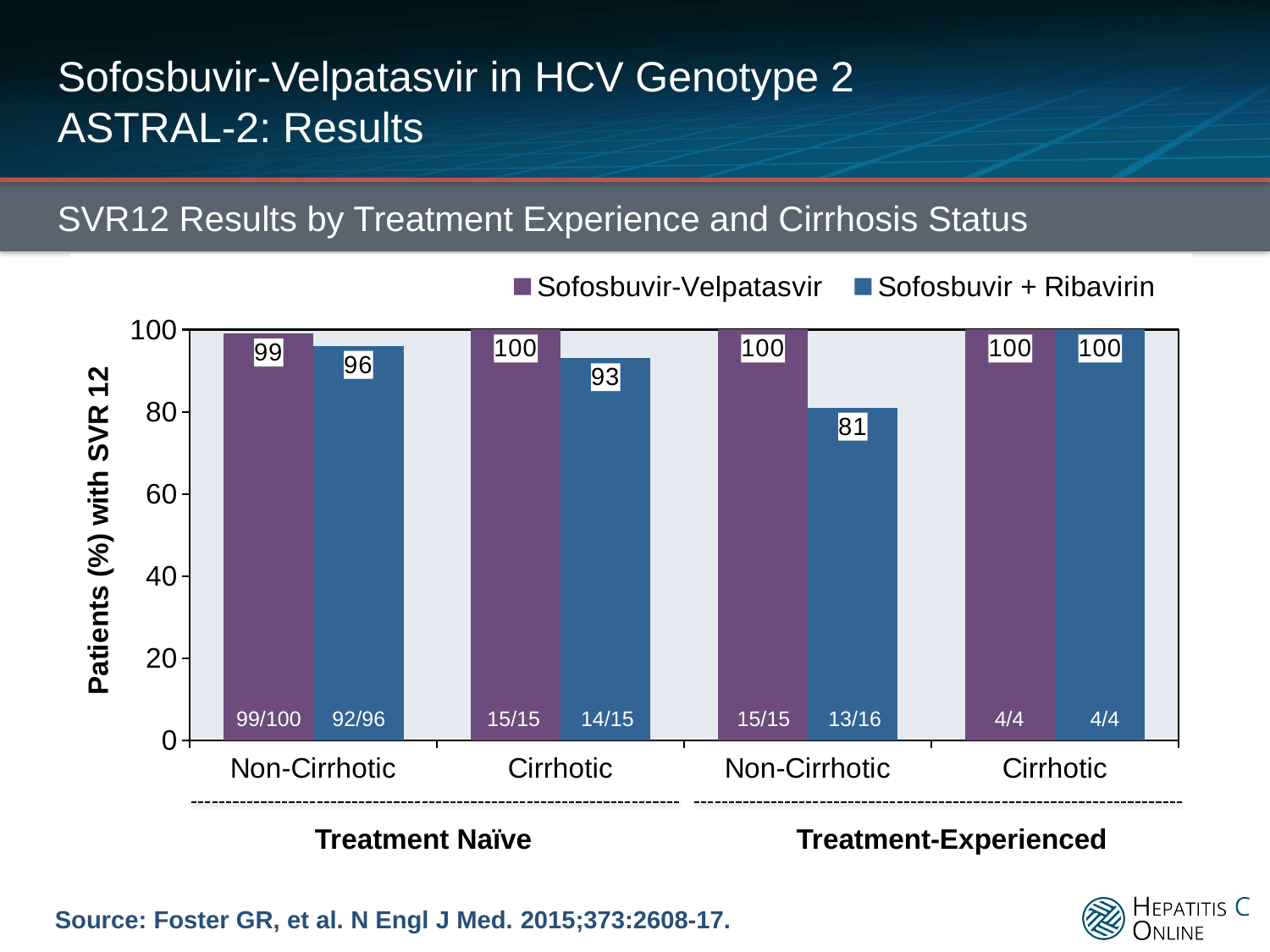
What is the difference between the Sofosbuvir-Velpatasvir and Sofosbuvir + Ribavirin SVR12 rates in Treatment Naïve Cirrhotic patients? 7 What is the label of the y axis? Patients (%) with SVR 12 What is the SVR12 rate for Sofosbuvir-Velpatasvir in Treatment Naïve Non-Cirrhotic patients? 99 How many series does the legend list? 2 How many category groups are shown on the x axis? 4 What is the difference between the Sofosbuvir-Velpatasvir and Sofosbuvir + Ribavirin SVR12 rates in Treatment-Experienced Non-Cirrhotic patients? 19 What fraction of patients is shown for Sofosbuvir + Ribavirin in the Treatment Naïve Non-Cirrhotic group? 92/96 What is the SVR12 rate for Sofosbuvir + Ribavirin in Treatment Naïve Cirrhotic patients? 93 What is the SVR12 rate for Sofosbuvir + Ribavirin in Treatment-Experienced Non-Cirrhotic patients? 81 Which group has the lowest SVR12 rate for Sofosbuvir + Ribavirin? Treatment-Experienced Non-Cirrhotic Which is larger in Treatment Naïve Non-Cirrhotic patients: the SVR12 rate for Sofosbuvir-Velpatasvir or for Sofosbuvir + Ribavirin? Sofosbuvir-Velpatasvir What kind of chart is shown on the slide? Bar chart